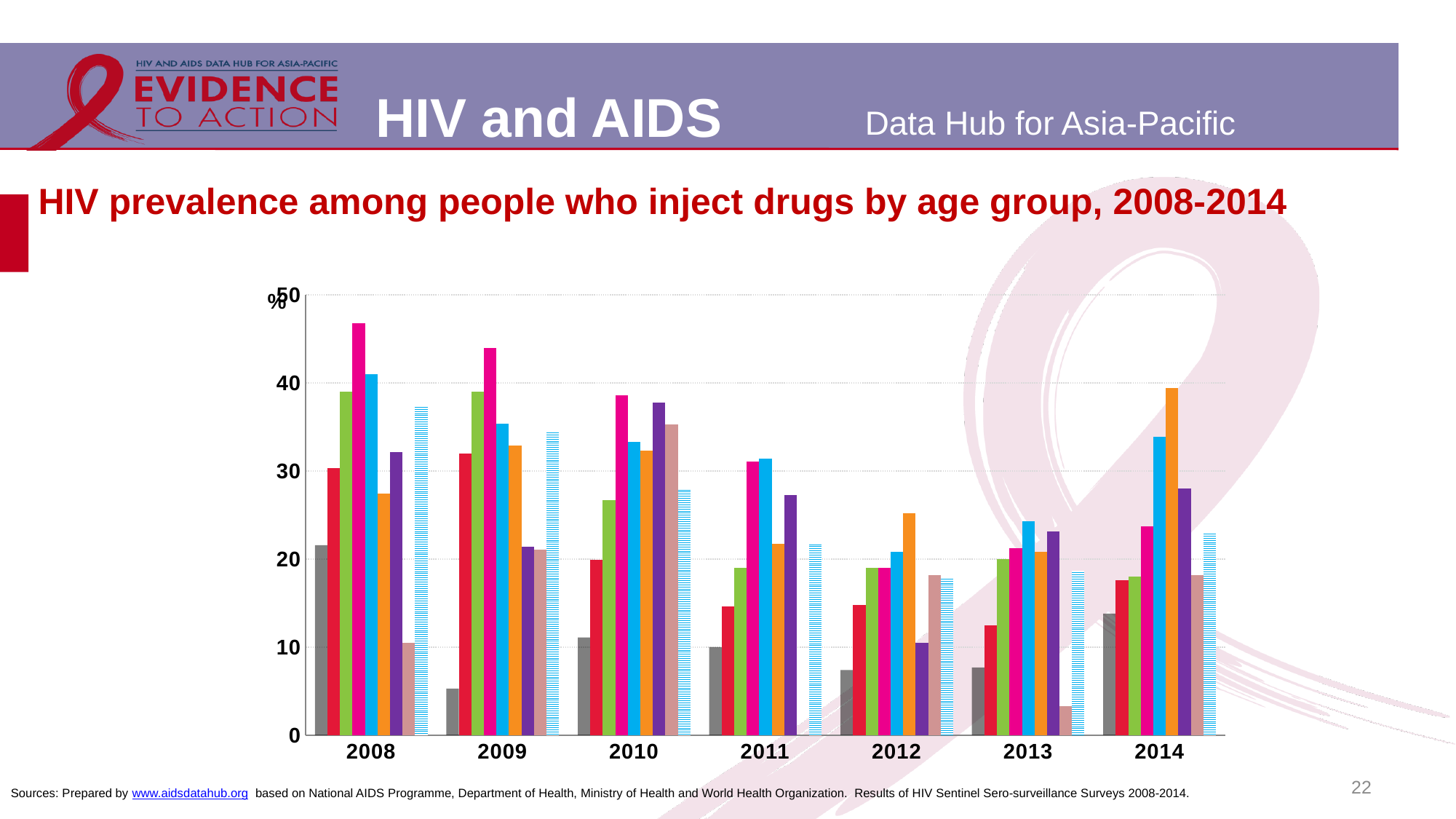
Which year has the taller tallest bar, 2009 or 2012? 2009 In which year does the shortest bar of the whole chart appear? 2013 Is the tallest bar in 2012 greater or less than 30? less How many years are shown along the x axis of the chart? 7 Is the tallest bar in 2014 greater or less than 30? greater What kind of chart is shown on the slide? bar chart What is the highest value shown on the y axis of the chart? 50 Is the tallest bar in 2011 greater or less than 40? less How many bars are plotted for the year 2008? 9 What is the title of the chart on the slide? HIV prevalence among people who inject drugs by age group, 2008-2014 In which year does the tallest bar of the whole chart appear? 2008